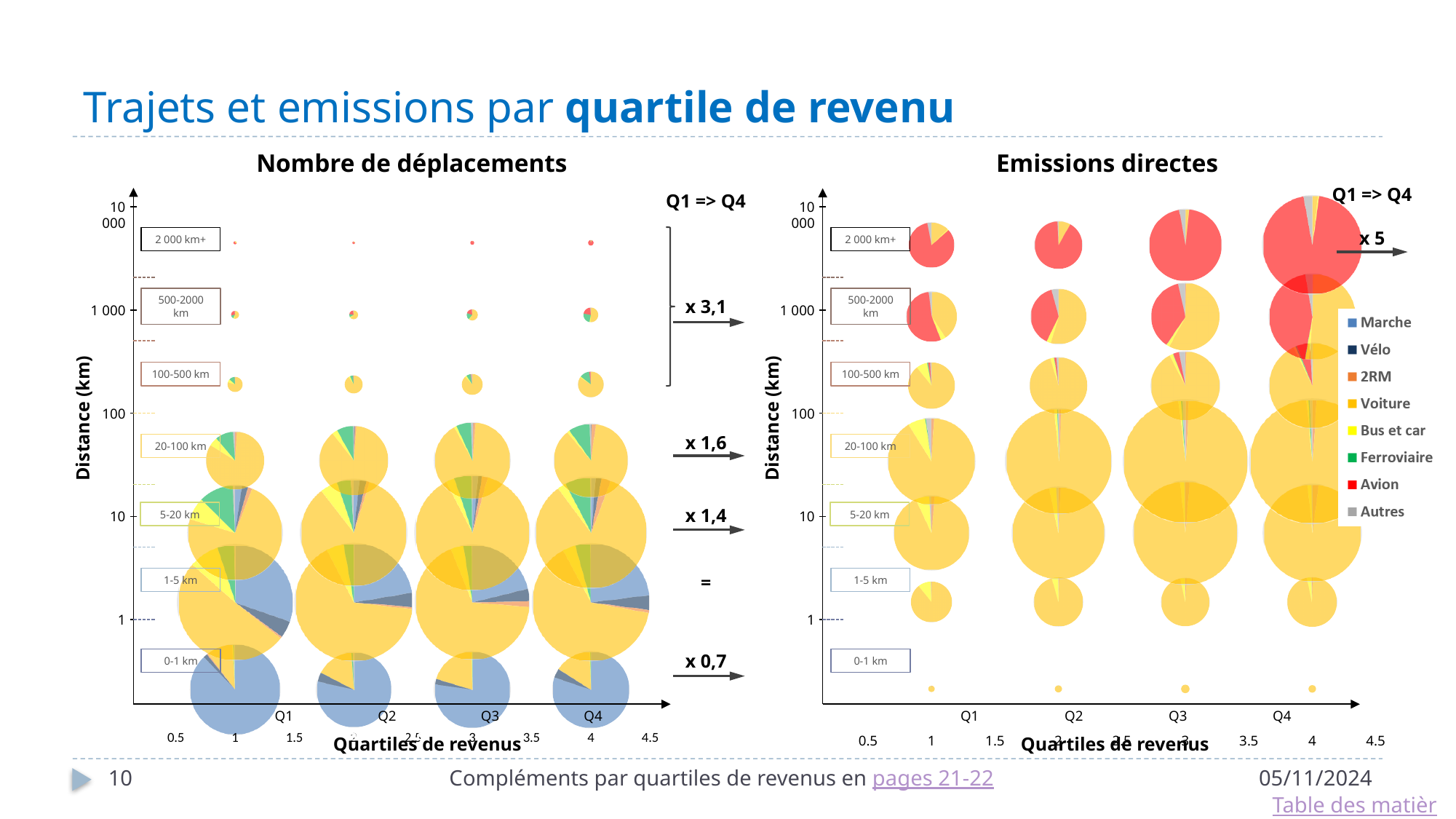
On the Nombre de déplacements chart, does the bubble size for the 0-1 km band rise or fall from Q1 to Q4? fall How many series does the legend on the Emissions directes chart list? 8 On the Emissions directes chart, is the 2 000 km+ bubble larger for Q1 or for Q4? Q4 How many distance bands are labelled along the y axis of the Emissions directes chart? 7 What is the title of the chart on the left side of the slide? Nombre de déplacements How many income quartiles are shown along the x axis of the Nombre de déplacements chart? 4 On the Nombre de déplacements chart, what multiplier is shown from Q1 to Q4 for the 5-20 km band? x 1,4 On the Nombre de déplacements chart, what multiplier is shown from Q1 to Q4 for the 0-1 km band? x 0,7 On the Nombre de déplacements chart, what multiplier is shown from Q1 to Q4 for the 20-100 km band? x 1,6 On the Emissions directes chart, which transport mode takes the largest share of the 2 000 km+ bubbles? Avion On the Emissions directes chart, what multiplier is shown from Q1 to Q4 for the 2 000 km+ band? x 5 What is the label of the x axis on the Emissions directes chart? Quartiles de revenus